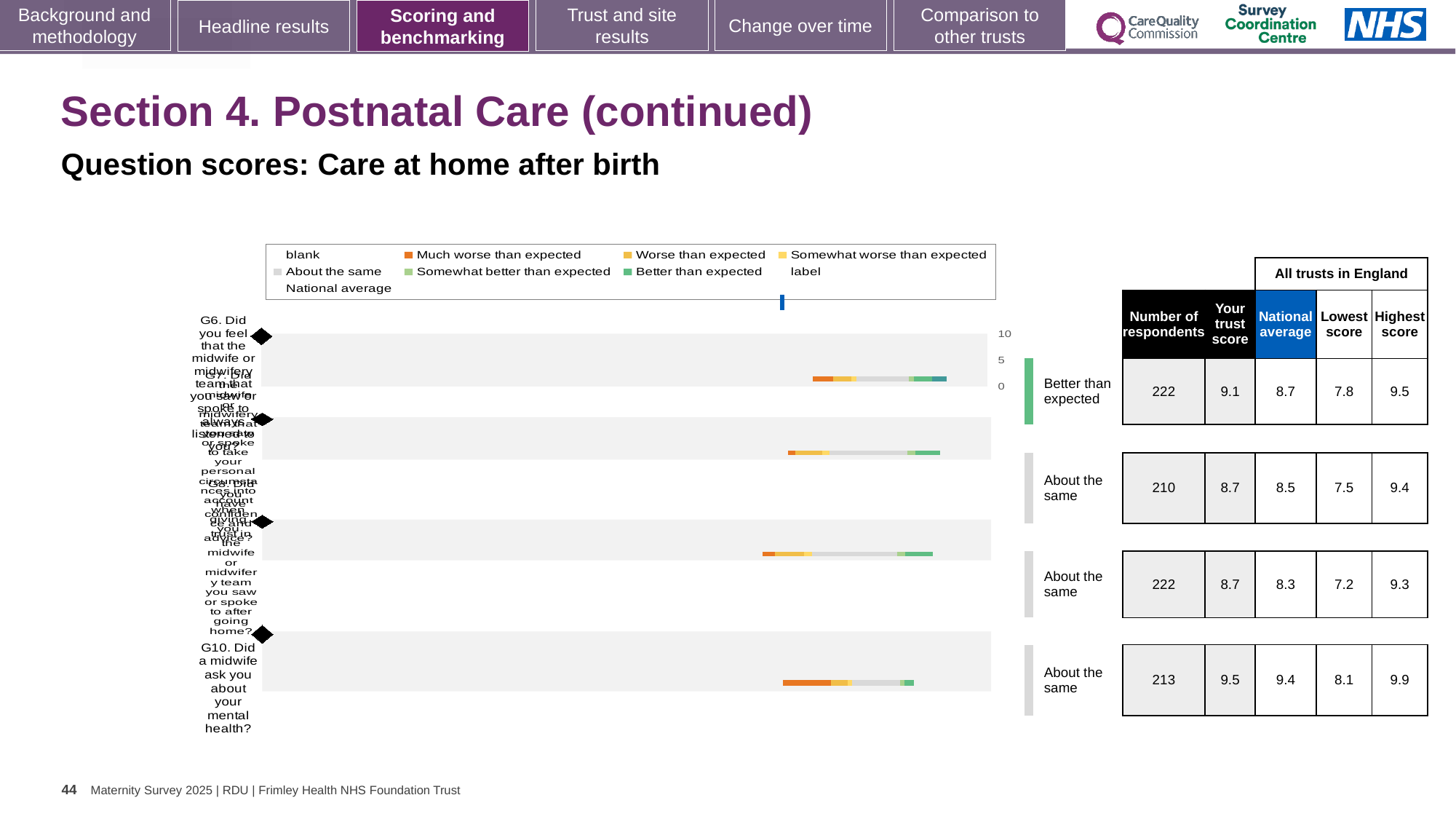
What colour does the legend use for 'Better than expected'? green In the table beside the chart, what is the trust score for the first row (G6)? 9.1 For G10, which is larger: the trust score or the national average? trust score In the table beside the chart, what is the trust score for G10 (Did a midwife ask you about your mental health?)? 9.5 Which question row has the highest trust score? G10 In the table beside the chart, how many respondents answered G10? 213 What is the subtitle describing the chart's content? Question scores: Care at home after birth For G10, what is the difference between the highest score and the lowest score across all trusts in England? 1.8 What benchmark category is shown for the first row (G6)? Better than expected What kind of chart is shown on the slide? bar chart In the table beside the chart, what is the national average for G10? 9.4 How many question bars are plotted in the chart? 4